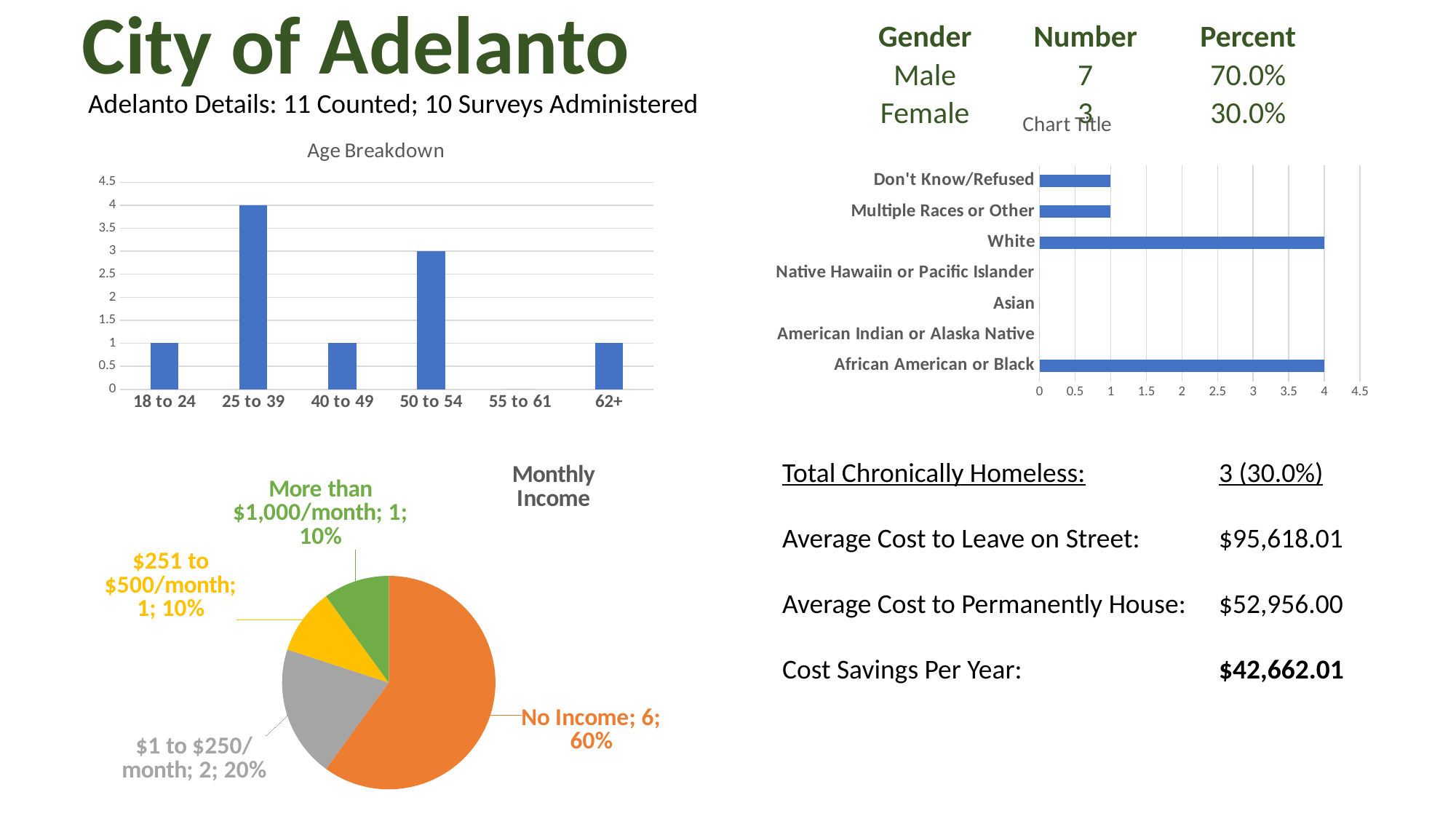
In the Monthly Income pie chart, what share does the No Income slice represent? 60% In the Age Breakdown chart, what is the difference between the values for 25 to 39 and 50 to 54? 1 In the horizontal bar chart on the right (titled "Chart Title"), how many categories are listed on the vertical axis? 7 In the Age Breakdown chart, what is the value for the 25 to 39 age group? 4 What kind of chart is the Age Breakdown chart? Bar chart In the Age Breakdown chart, what is the value for the 50 to 54 age group? 3 In the horizontal bar chart on the right (titled "Chart Title"), is the value for Multiple Races or Other greater or less than 2? less In the Age Breakdown chart, how many age categories are shown on the x axis? 6 In the horizontal bar chart on the right (titled "Chart Title"), which is larger: the value for African American or Black or the value for Don't Know/Refused? African American or Black In the Age Breakdown chart, which age group has the highest value? 25 to 39 In the horizontal bar chart on the right (titled "Chart Title"), what is the value for White? 4 In the Monthly Income pie chart, what is the count for the $1 to $250/month slice? 2